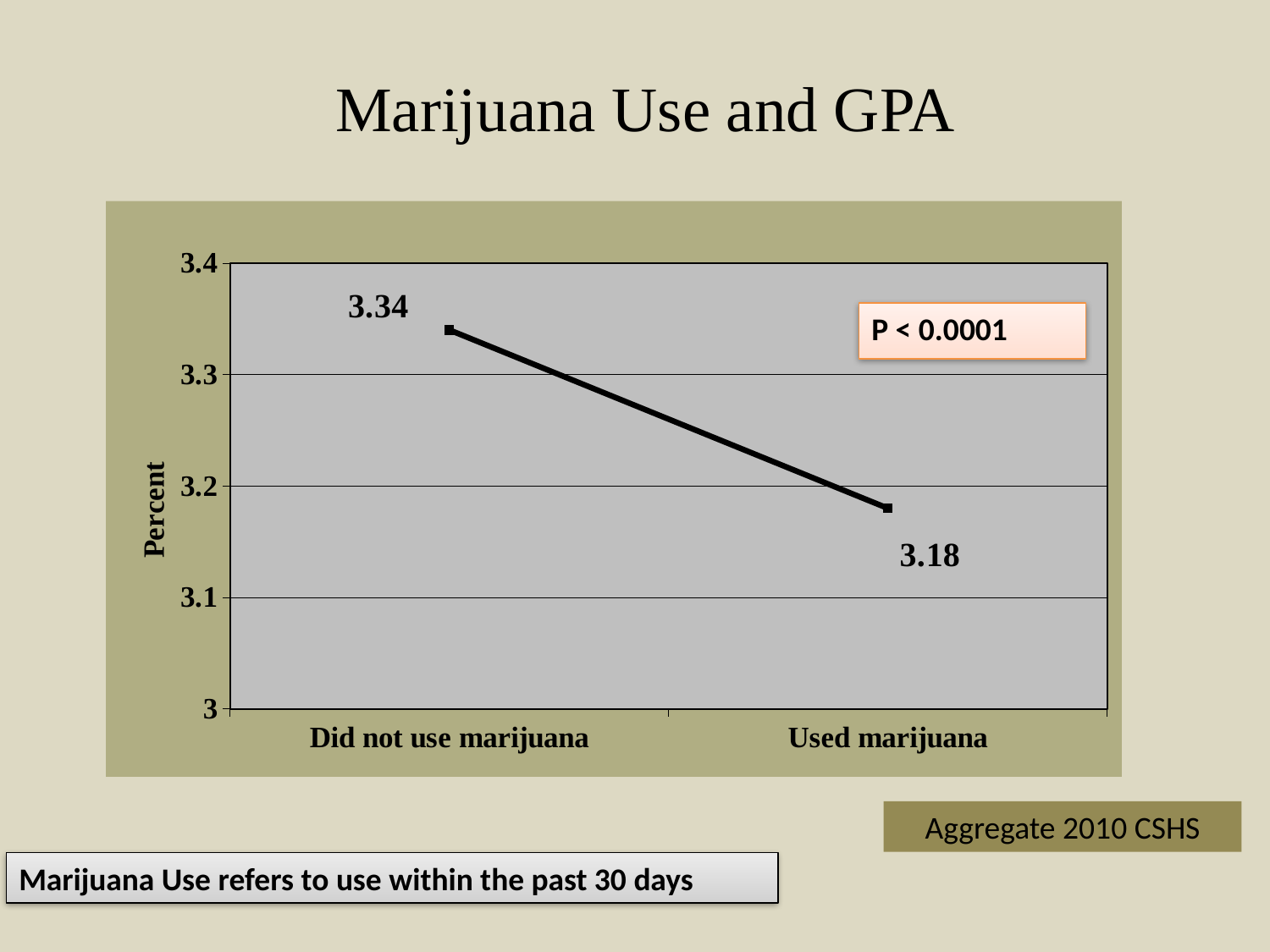
Which category has the lowest value? Used marijuana How many categories are shown on the x axis? 2 What is the title of the slide? Marijuana Use and GPA What is the difference between the values for "Did not use marijuana" and "Used marijuana"? 0.16 Is the value for "Did not use marijuana" greater or less than 3.3? greater Do the values rise or fall from "Did not use marijuana" to "Used marijuana"? fall Is the value for "Used marijuana" greater or less than 3.2? less Which category has the highest value? Did not use marijuana What kind of chart is shown on the slide? line chart What is the value for "Did not use marijuana"? 3.34 Which is larger, the value for "Did not use marijuana" or the value for "Used marijuana"? Did not use marijuana What is the value for "Used marijuana"? 3.18